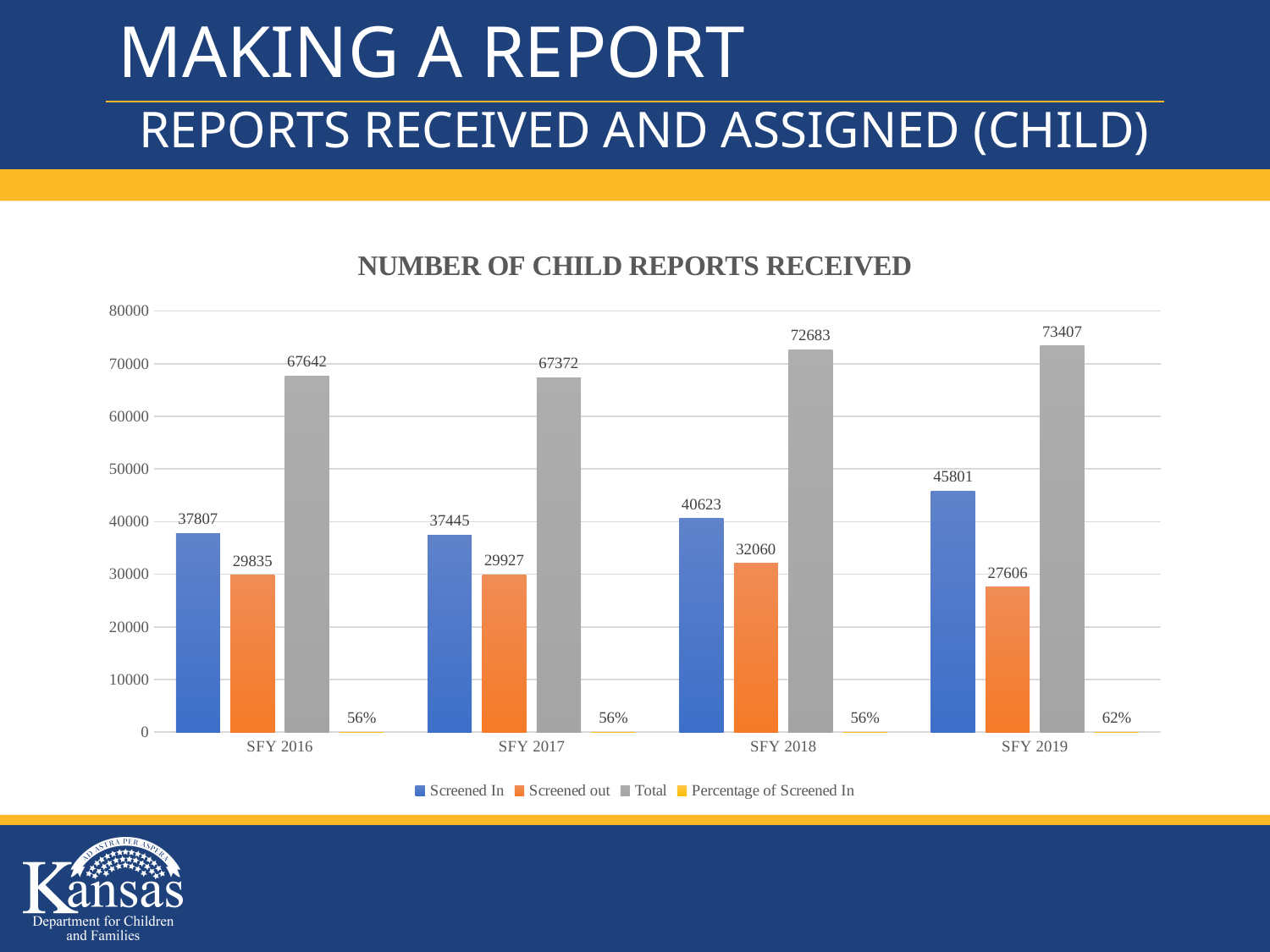
What is the Total value for SFY 2016? 67642 What is the Percentage of Screened In for SFY 2019? 62% What is the difference between the Screened In values for SFY 2019 and SFY 2018? 5178 What is the Screened out value for SFY 2018? 32060 How many series does the legend list? 4 Which year has the highest Total value? SFY 2019 How many years are shown on the x axis? 4 Which is larger, the Screened out value for SFY 2016 or for SFY 2017? SFY 2017 What kind of chart is shown? bar chart Which year has the lowest Screened out value? SFY 2019 What is the title of the chart? NUMBER OF CHILD REPORTS RECEIVED What is the Screened In value for SFY 2019? 45801